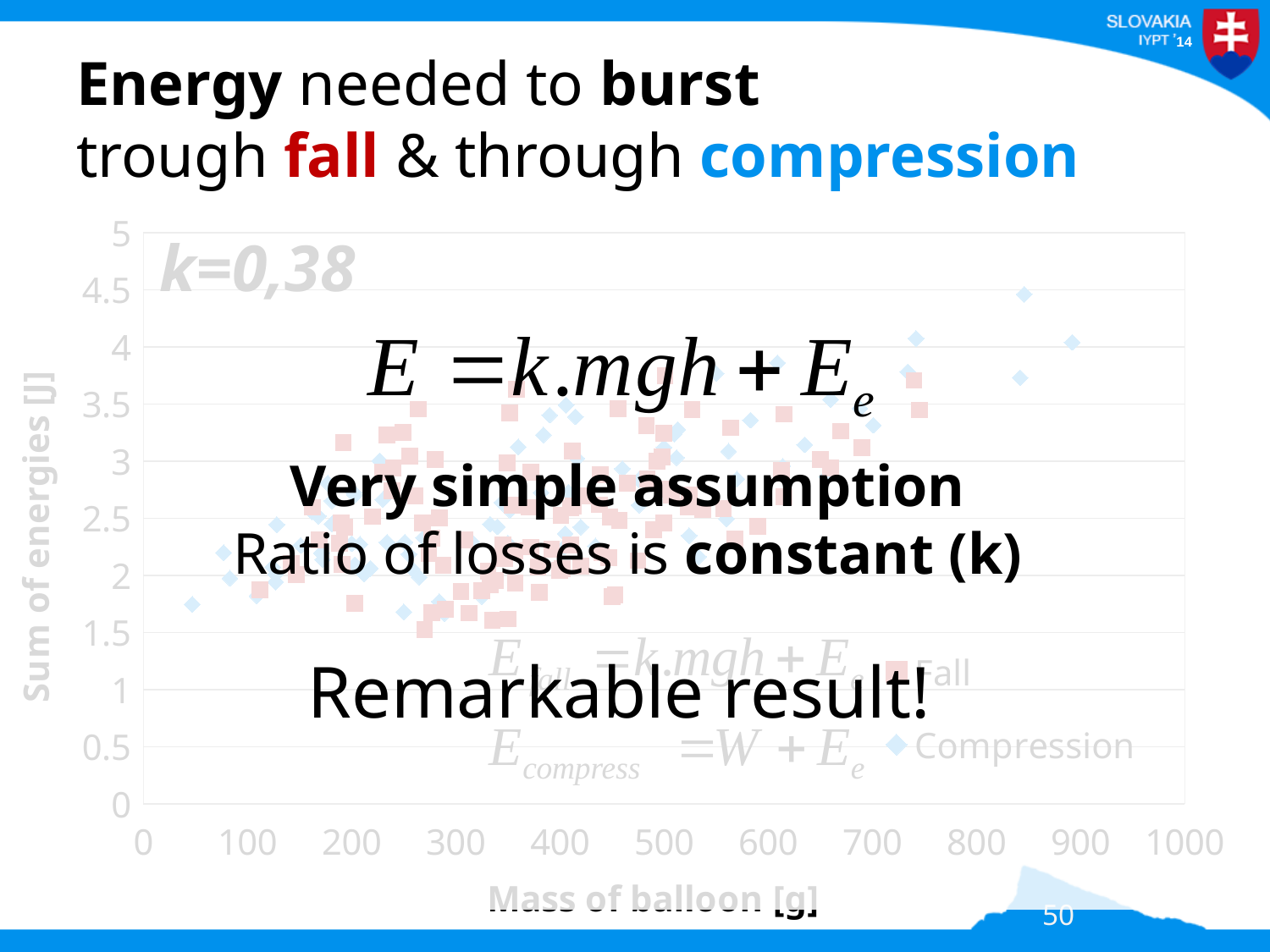
What kind of chart is shown on the slide? scatter chart What is the title of the chart's x axis? Mass of balloon [g] What are the two series named in the chart's legend? Fall and Compression As the mass of balloon increases along the x axis, do the plotted energy values generally rise or fall? rise How many series does the chart's legend list? 2